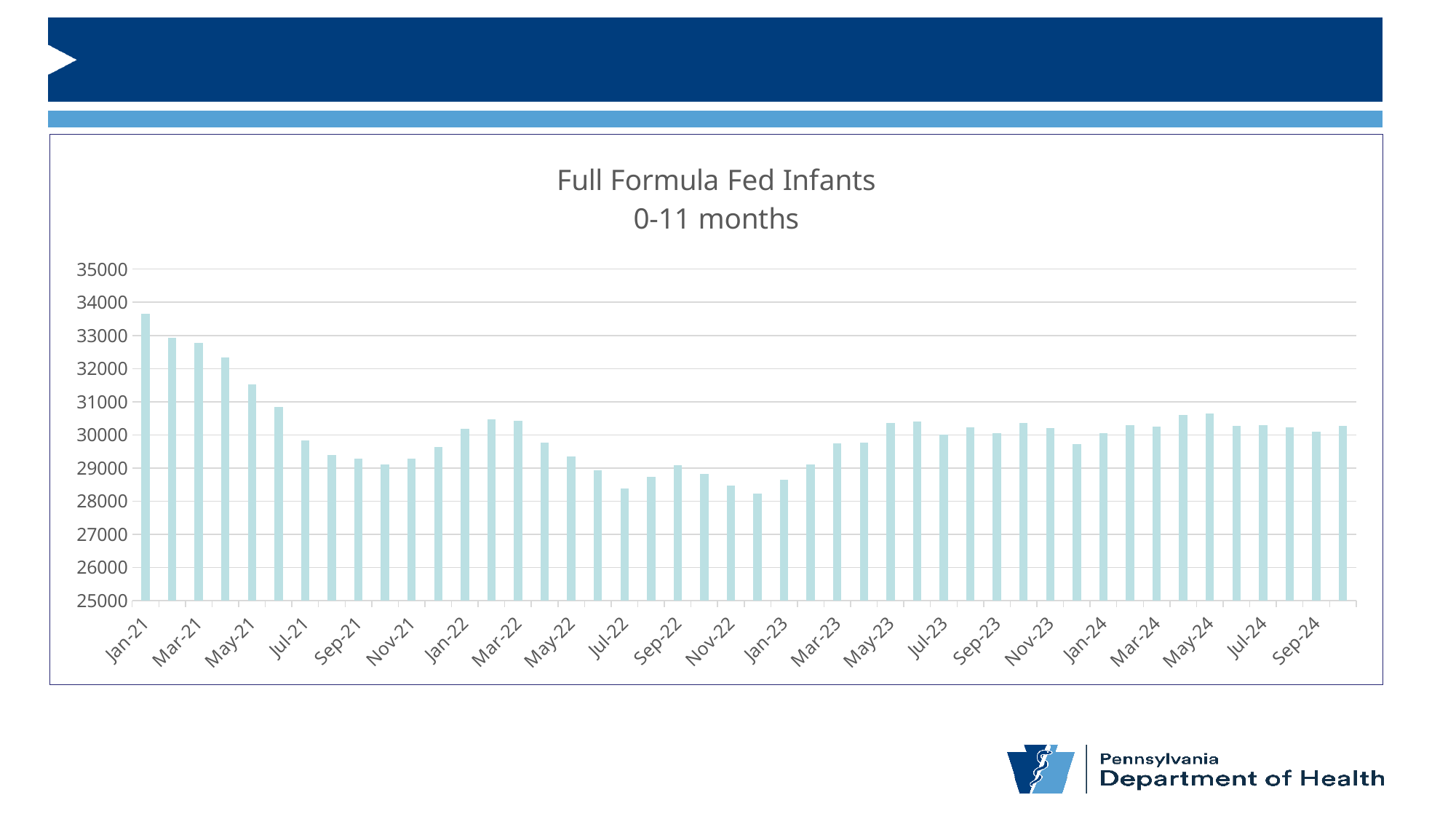
Is the value for May-24 greater or less than 30000? greater Is the value for Sep-21 greater or less than 30000? less Is the value for Nov-22 greater or less than 29000? less Which month has the highest value in the chart? Jan-21 What is the title of the chart? Full Formula Fed Infants 0-11 months What kind of chart is shown on the slide? bar chart Do the values rise or fall from Dec-22 to May-23? rise Which is larger, the value for Jan-21 or the value for Sep-24? Jan-21 Do the values rise or fall from Jan-21 to Jun-21? fall